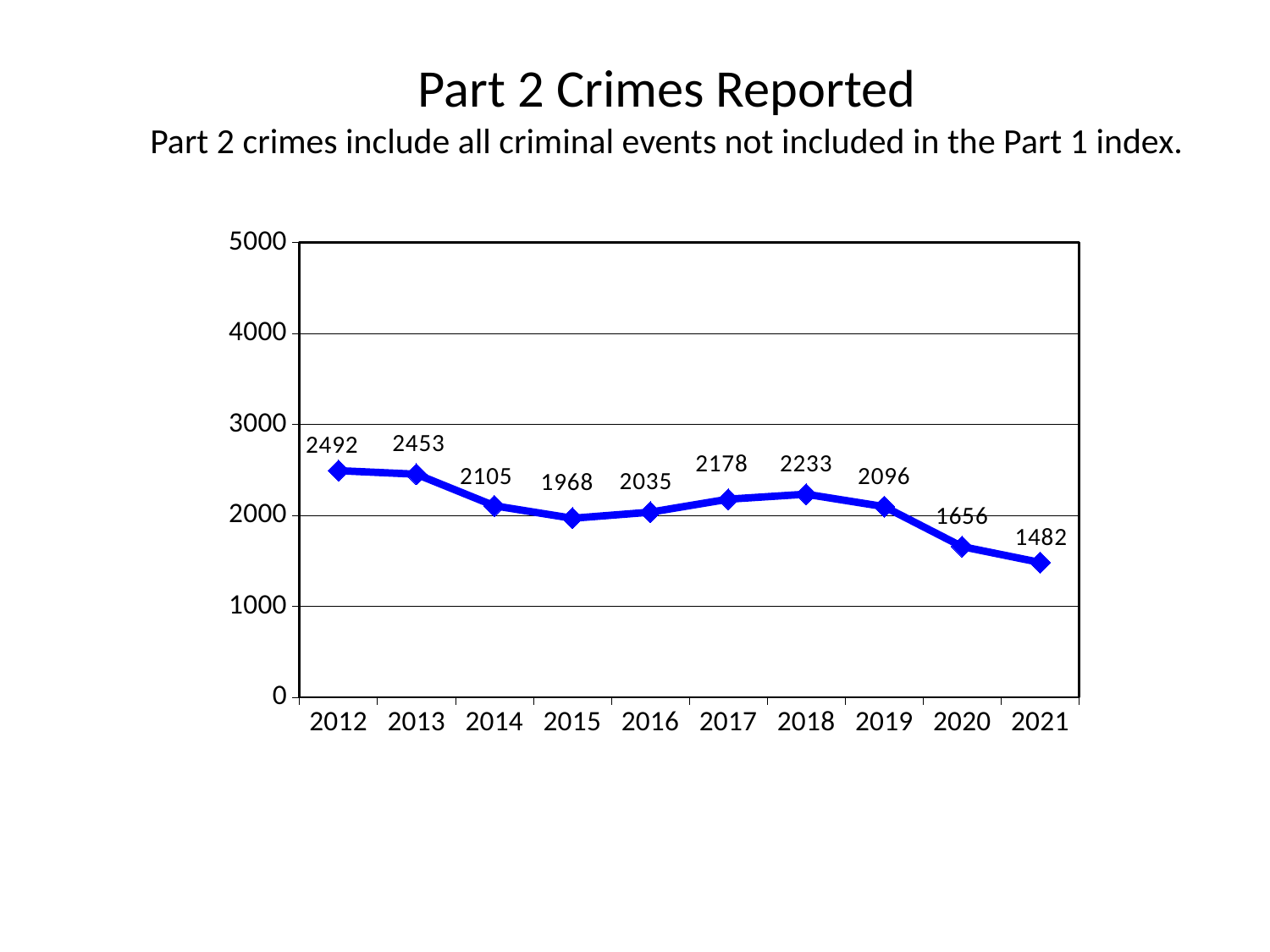
What kind of chart is shown on the slide? line chart What is the difference between the values for 2019 and 2020? 440 Which year has a larger value, 2015 or 2017? 2017 Do the values generally rise or fall from 2018 to 2021? fall What is the number of Part 2 crimes reported in 2012? 2492 What is the difference between the values for 2012 and 2021? 1010 What is the number of Part 2 crimes reported in 2018? 2233 What is the number of Part 2 crimes reported in 2021? 1482 Which year has the highest number of Part 2 crimes reported? 2012 Which year has the lowest number of Part 2 crimes reported? 2021 How many years are plotted on the chart? 10 Is the value for 2020 greater or less than 2000? less